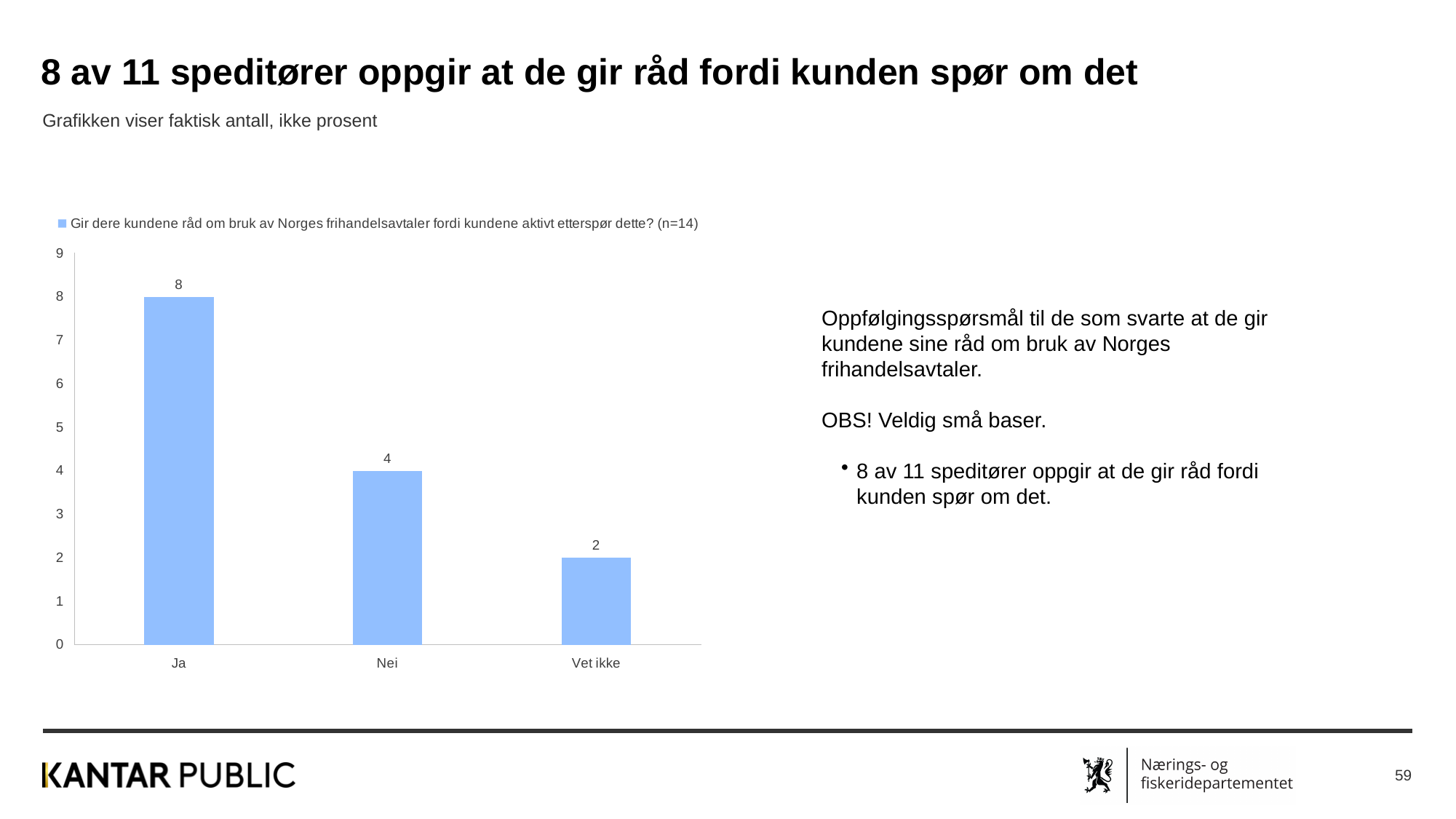
How many categories are shown on the x axis? 3 What is the value for "Ja"? 8 What is the value for "Nei"? 4 Do the values rise or fall from left to right along the x axis? Fall How many series does the legend list? 1 Which category has the highest value? Ja Which category has the lowest value? Vet ikke Which is larger, the value for "Nei" or the value for "Vet ikke"? Nei What kind of chart is shown on the slide? Bar chart What is the difference between the values for "Nei" and "Vet ikke"? 2 What is the value for "Vet ikke"? 2 What is the difference between the values for "Ja" and "Nei"? 4